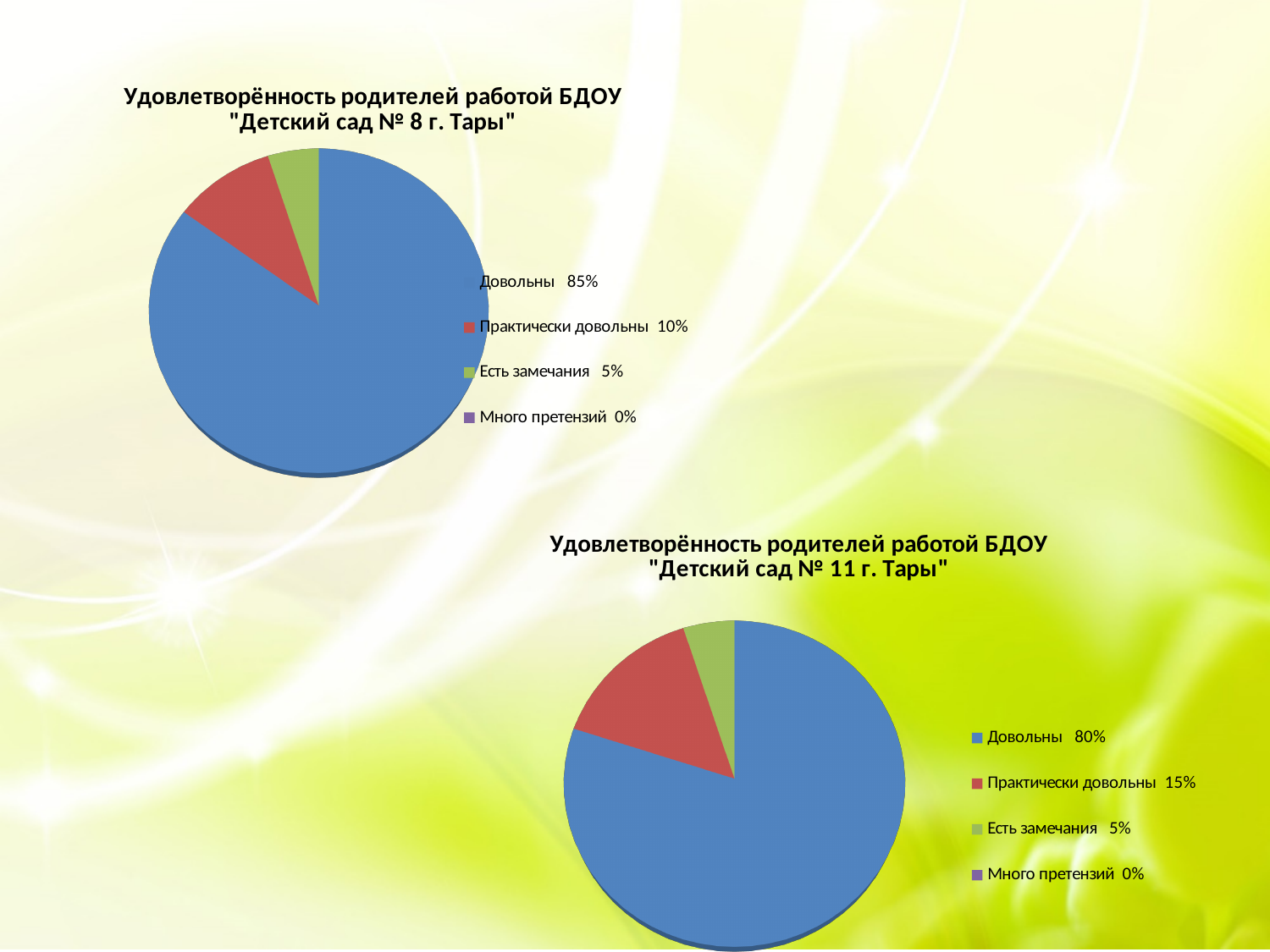
In the chart for "Детский сад № 11 г. Тары", which category has the smallest share? Много претензий Which chart shows a larger share for "Довольны": "Детский сад № 8 г. Тары" or "Детский сад № 11 г. Тары"? Детский сад № 8 г. Тары In the chart for "Детский сад № 8 г. Тары", which category has the largest slice? Довольны In the chart for "Детский сад № 8 г. Тары", what is the difference between the shares for "Довольны" and "Практически довольны"? 75% How many categories does the legend of the chart for "Детский сад № 11 г. Тары" list? 4 In the chart for "Детский сад № 11 г. Тары", what share is shown for "Практически довольны"? 15% In the chart for "Детский сад № 11 г. Тары", what share is shown for "Есть замечания"? 5% What type of chart is used for "Детский сад № 8 г. Тары"? Pie chart In the chart for "Детский сад № 11 г. Тары", what share is shown for "Довольны"? 80% In the chart for "Детский сад № 8 г. Тары", what share is shown for "Практически довольны"? 10% In the chart for "Детский сад № 8 г. Тары", what colour is the slice for "Практически довольны"? Red In the chart "Удовлетворённость родителей работой БДОУ "Детский сад № 8 г. Тары"", what share is shown for "Довольны"? 85%